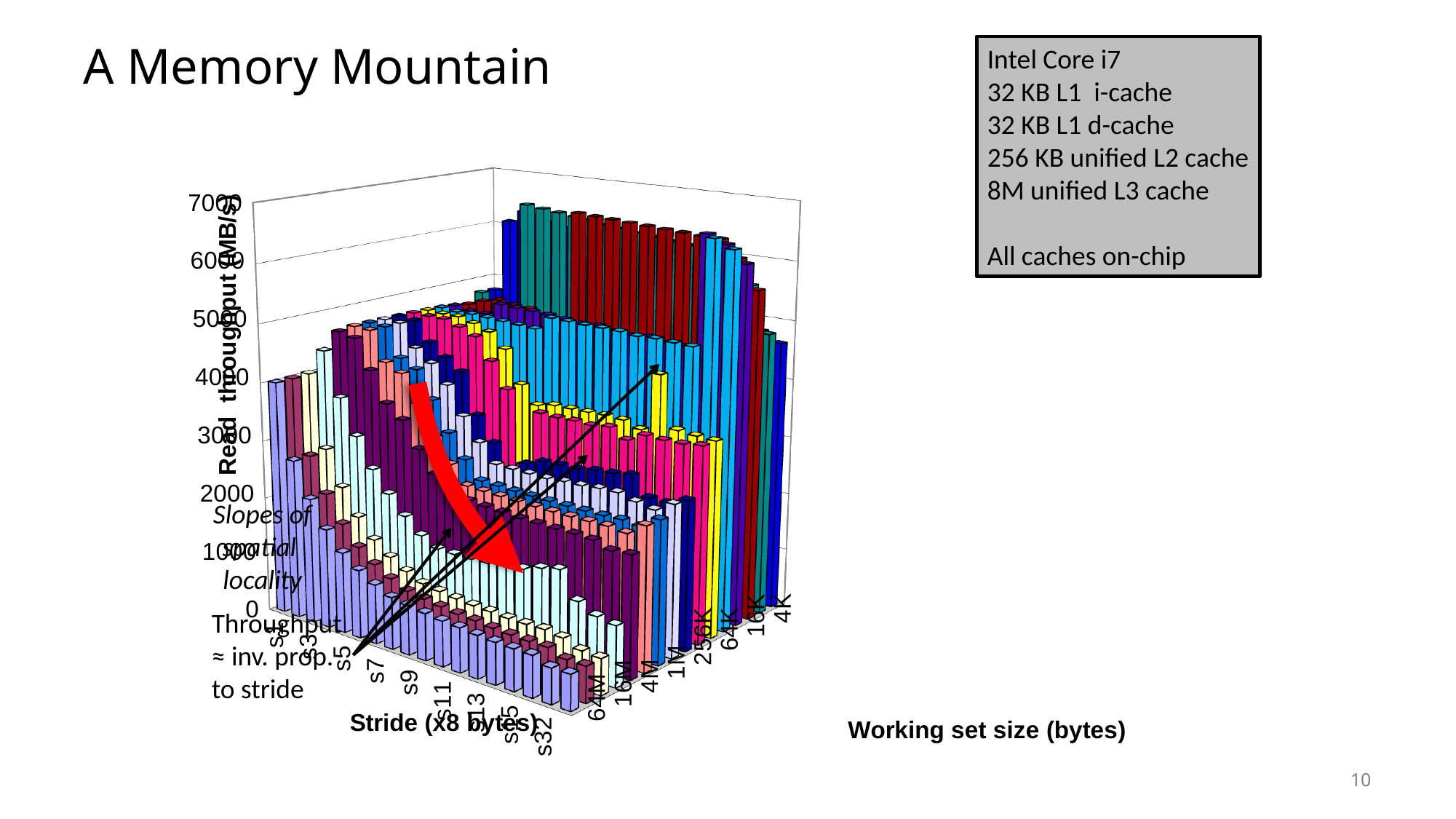
What is the title of the chart on the slide? A Memory Mountain Which is larger: the read throughput at stride s1 with working set 4K, or at stride s32 with working set 64M? s1 with working set 4K Is the read throughput for stride s32 at working set size 64M greater or less than 1000? less What kind of chart is shown on the slide? 3D bar chart For a fixed stride, does read throughput rise or fall as the working set size increases from 4K to 64M? fall What is the highest tick value shown on the Read throughput axis? 7000 How many stride labels are shown along the stride axis of the chart? 9 How many working set size labels are shown along the depth axis of the chart? 8 What is the label of the vertical axis of the chart? Read throughput (MB/s)